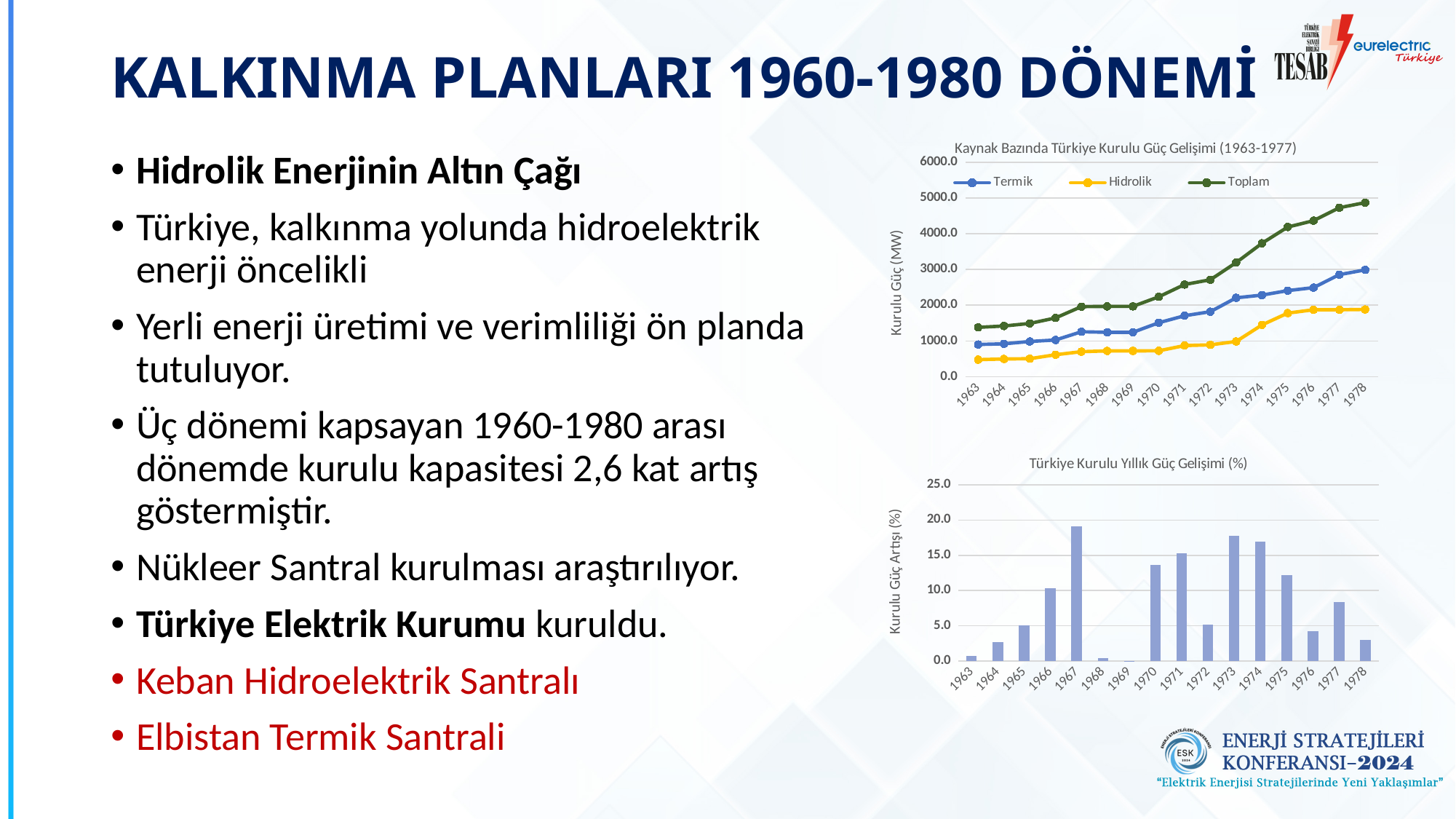
In the bottom chart, which year has the lowest bar? 1969 What kind of chart is the bottom chart titled 'Türkiye Kurulu Yıllık Güç Gelişimi (%)'? bar chart How many years are shown on the x axis of the bottom chart? 16 How many series does the legend of the top chart list? 3 In the bottom chart, which year has the highest bar? 1967 What are the series names in the legend of the top chart? Termik, Hidrolik, Toplam What kind of chart is the top chart titled 'Kaynak Bazında Türkiye Kurulu Güç Gelişimi (1963-1977)'? line chart In the top chart, does the Toplam series rise or fall from 1963 to 1978? rise In the bottom chart, which year has the larger value, 1971 or 1975? 1971 In the top chart, is the Toplam value for 1978 greater or less than 4000? greater